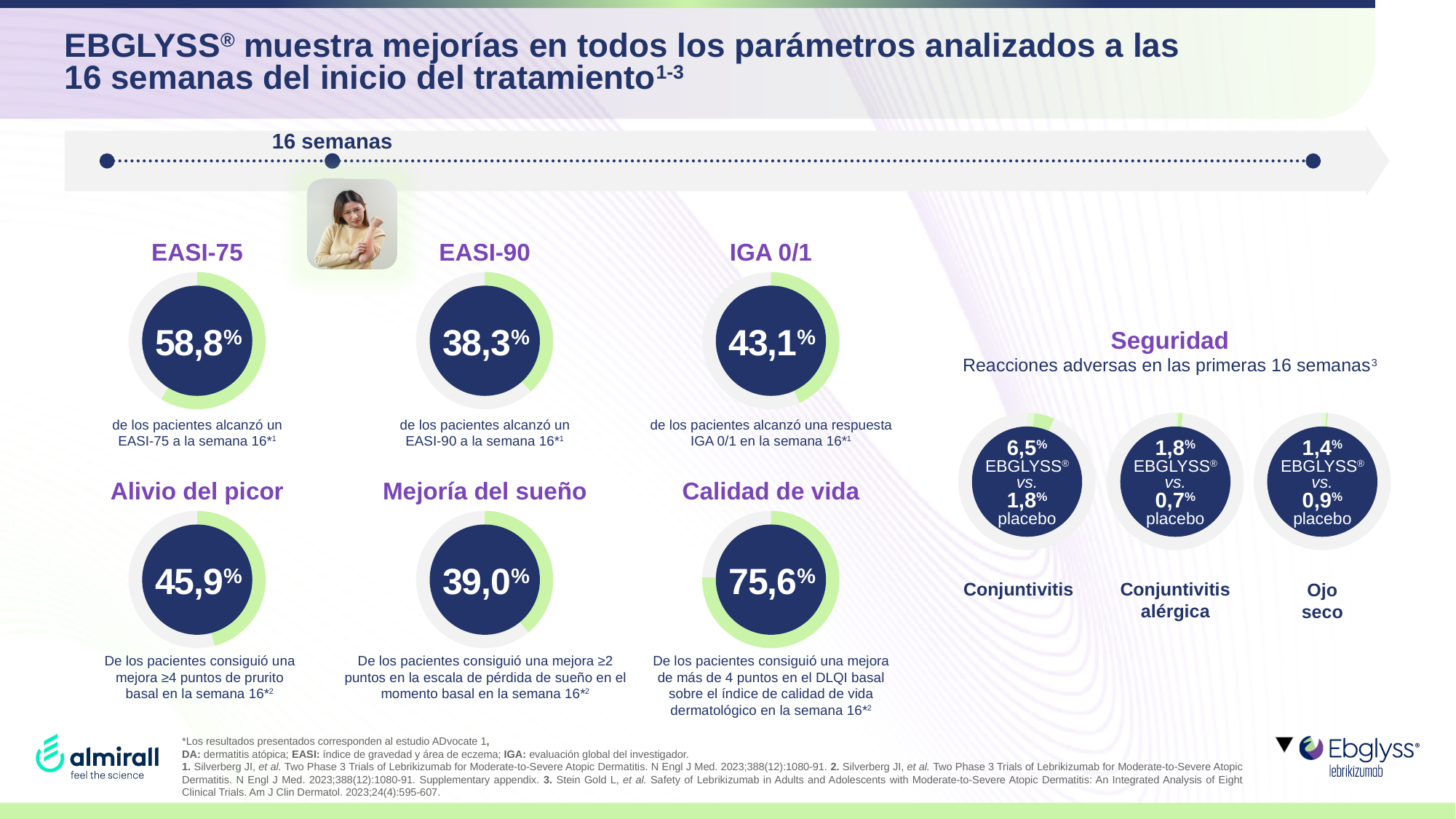
What is the difference between the EASI-75 value and the EASI-90 value? 20,5% Among the six efficacy ring charts (EASI-75, EASI-90, IGA 0/1, Alivio del picor, Mejoría del sueño, Calidad de vida), which shows the highest percentage? Calidad de vida In the IGA 0/1 ring chart, what percentage of patients achieved an IGA 0/1 response at week 16? 43,1% In the 'Mejoría del sueño' ring chart, what value is shown? 39,0% Among the six efficacy ring charts, which shows the lowest percentage? EASI-90 In the 'Seguridad' section, what is the EBGLYSS rate for Conjuntivitis? 6,5% In the EASI-90 ring chart, what value is shown? 38,3% In the 'Calidad de vida' ring chart, what value is shown? 75,6% In the 'Seguridad' section, what is the placebo rate for Ojo seco? 0,9% In the EASI-75 ring chart, what percentage of patients achieved EASI-75 at week 16? 58,8% In the 'Seguridad' section, what is the difference between the EBGLYSS and placebo rates for Conjuntivitis alérgica? 1,1% Which is larger, the 'Alivio del picor' value or the IGA 0/1 value? Alivio del picor